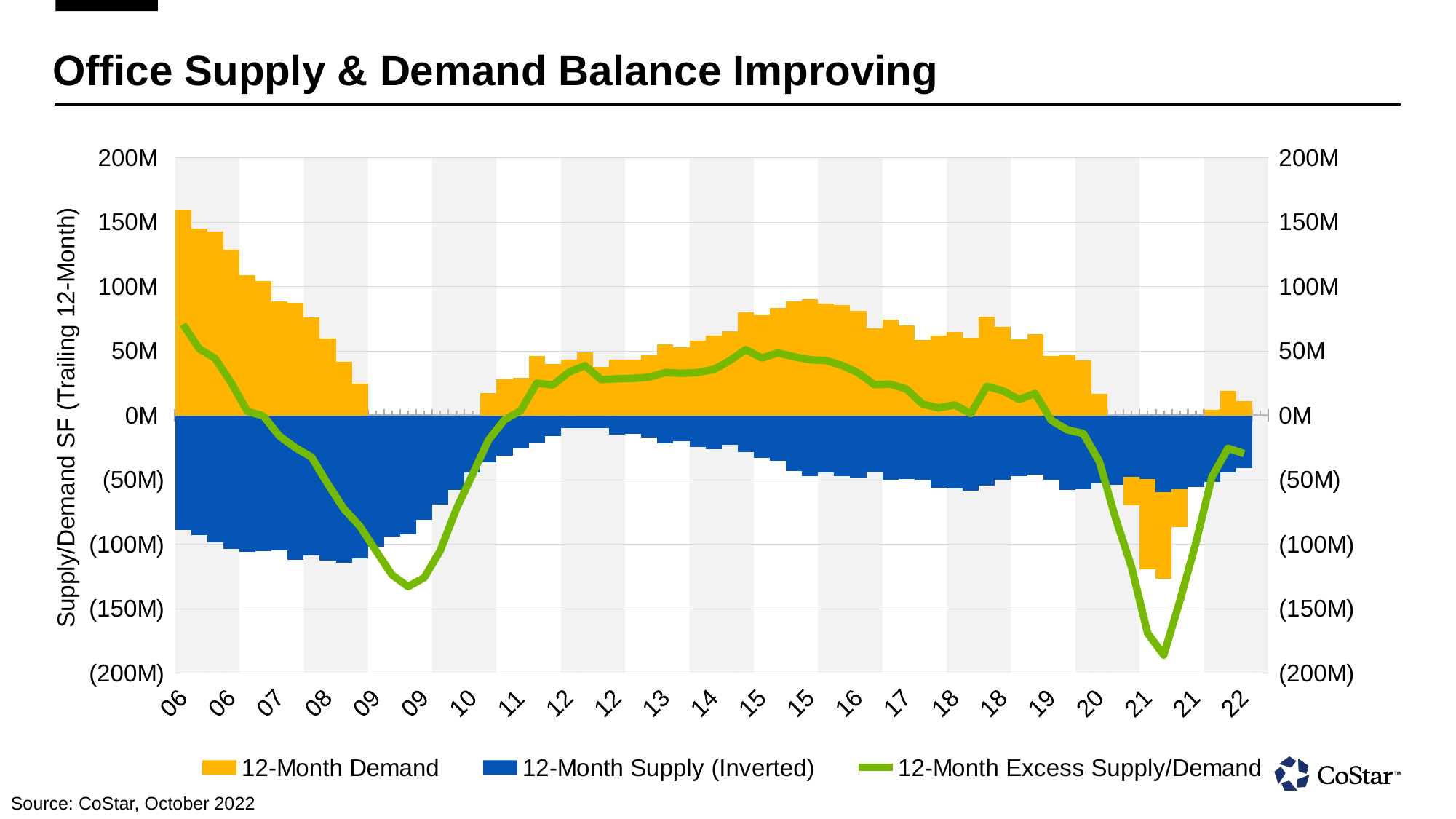
Does the 12-Month Excess Supply/Demand line rise or fall from its low point in 21 to 22? rise Is the 12-Month Demand value at the first bar (06) greater or less than 150M? greater Which series is plotted as a green line? 12-Month Excess Supply/Demand How many series does the chart's legend list? 3 Does 12-Month Demand rise or fall from 06 to 09? fall Is the peak 12-Month Demand value around 15 greater or less than 100M? less Is the lowest point of the 12-Month Excess Supply/Demand line (around 21) greater or less than (150M)? less What kind of chart is shown on the slide? Combined bar and line chart In which year label does the 12-Month Demand series reach its highest value? 06 In which year label does the 12-Month Excess Supply/Demand line reach its lowest value? 21 What is the title of the chart on the slide? Office Supply & Demand Balance Improving